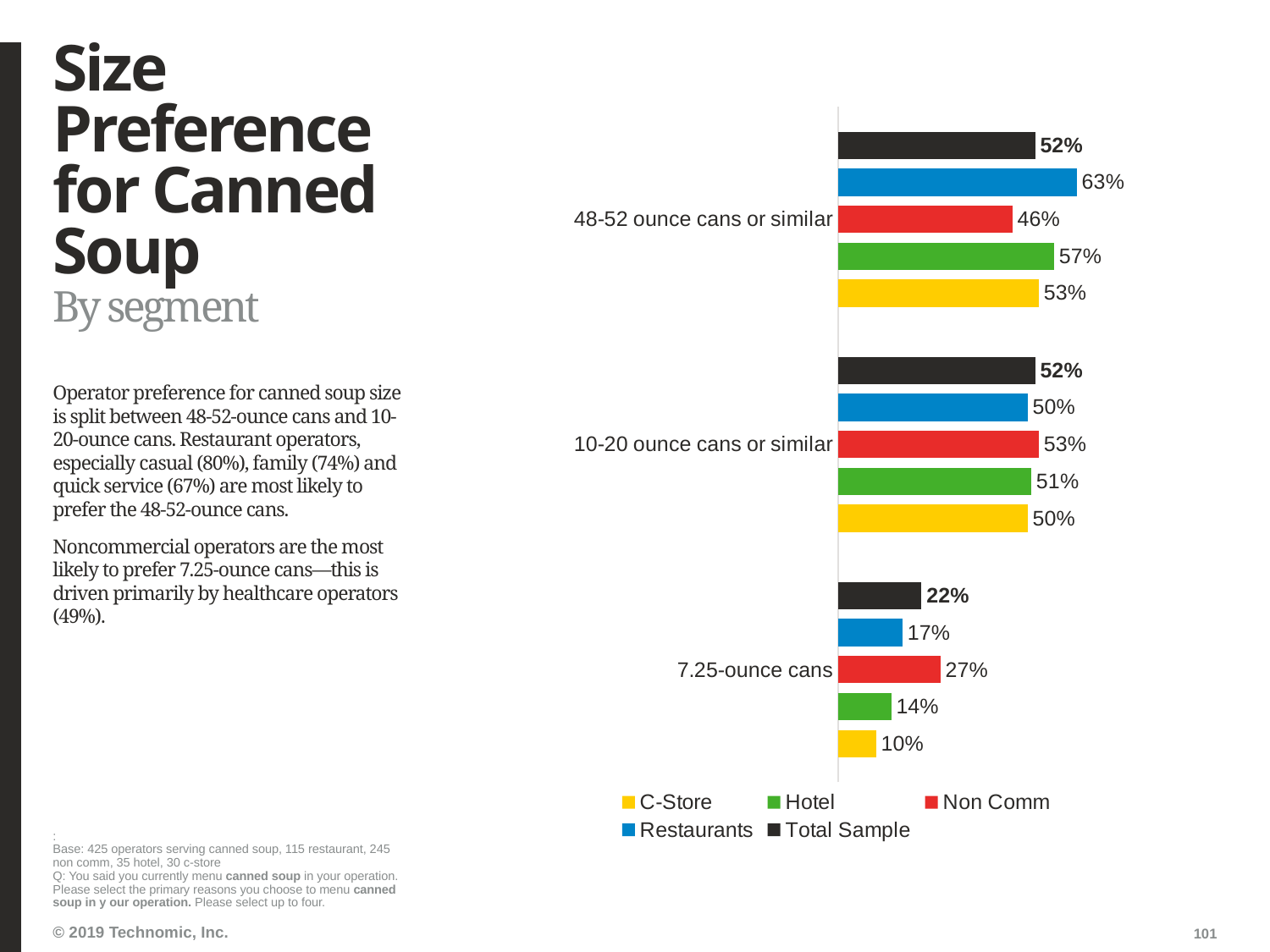
What is the Total Sample value for 10-20 ounce cans or similar? 52% Which is larger for 7.25-ounce cans: the Hotel value or the Restaurants value? Restaurants What is the Restaurants value for 48-52 ounce cans or similar? 63% What is the difference between the Restaurants and Non Comm values for 48-52 ounce cans or similar? 17% How many can-size categories are shown in the chart? 3 What is the C-Store value for 7.25-ounce cans? 10% What type of chart is shown on the slide? Bar chart How many series does the legend list? 5 Which segment has the highest value for 48-52 ounce cans or similar? Restaurants What is the Non Comm value for 7.25-ounce cans? 27% Which segment has the lowest value for 7.25-ounce cans? C-Store Which colour represents the Hotel series in the chart? Green